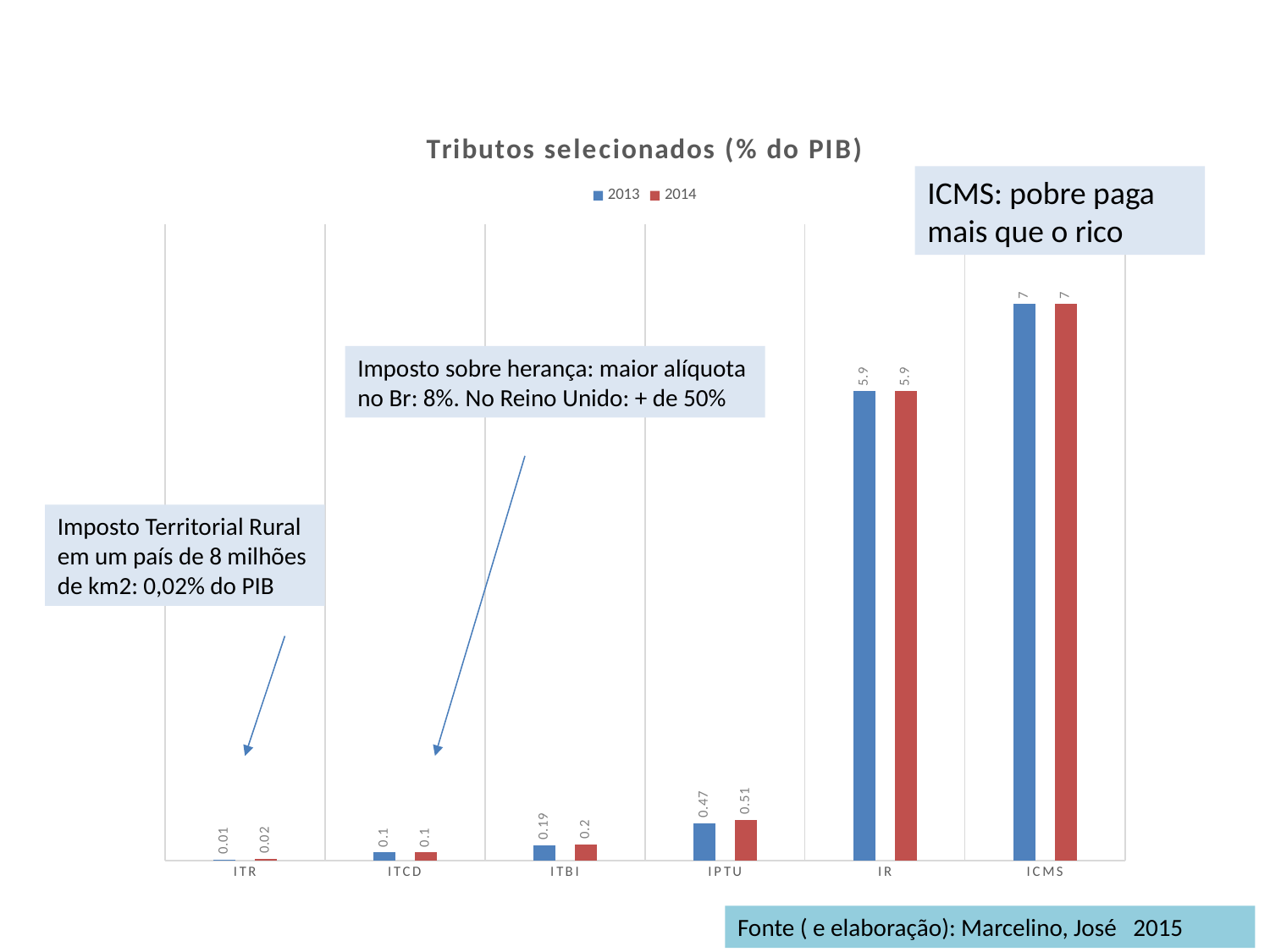
What is the value for ITBI in 2014? 0.2 What is the value for ITR in 2013? 0.01 What is the value for IPTU in 2013? 0.47 What kind of chart is shown on the slide? Bar chart Which category has the lowest value in 2014? ITR How many series does the legend list? 2 Which is larger, the 2013 value for IR or the 2013 value for IPTU? IR How many categories are shown on the x axis? 6 What is the difference between the 2014 and 2013 values for IPTU? 0.04 What is the difference between the ICMS and IR values in 2013? 1.1 What is the value for ICMS in 2014? 7 Which category has the highest value in 2013? ICMS